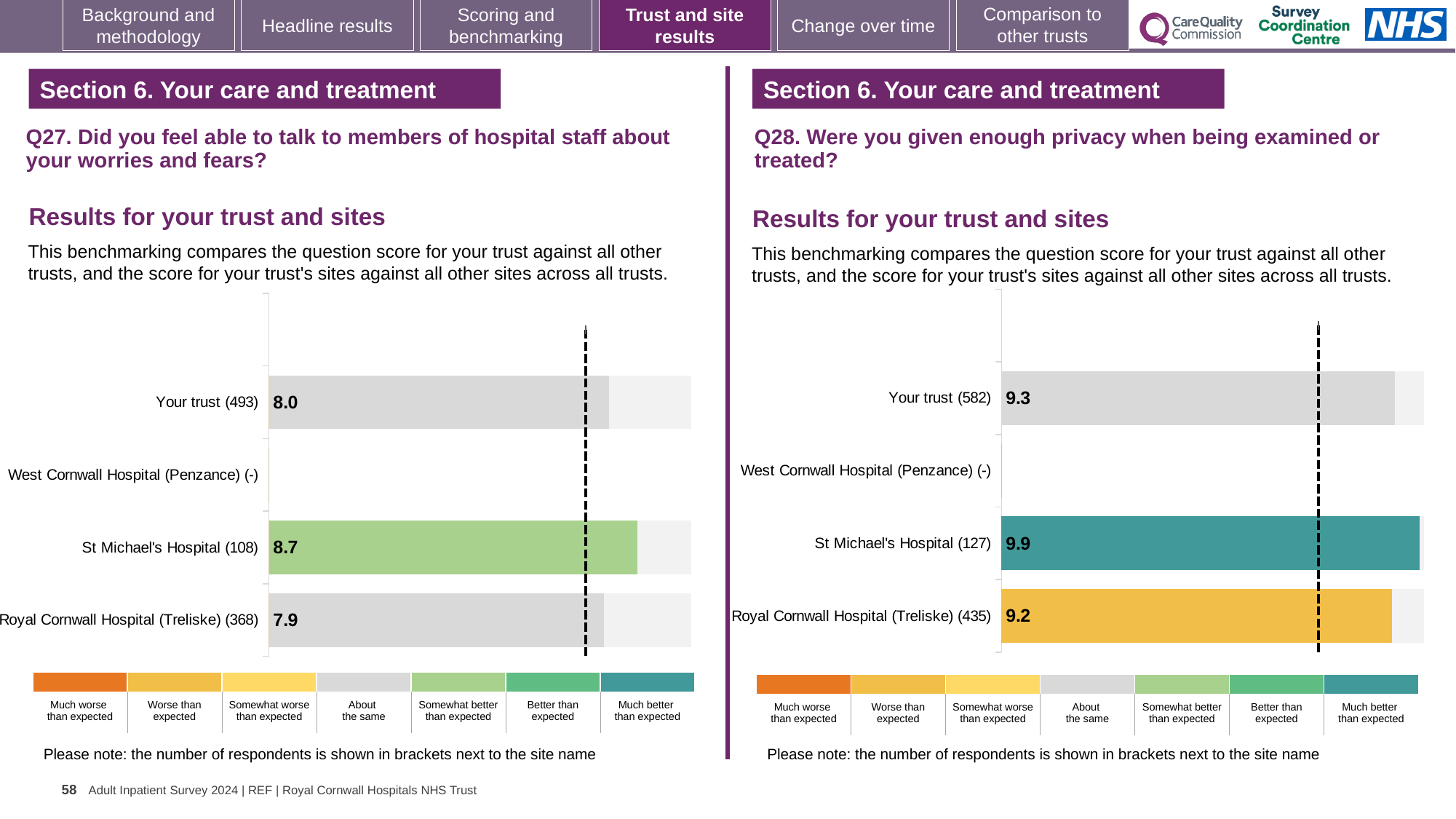
On the Q28 chart (right), what is the score for St Michael's Hospital? 9.9 On the Q27 chart (left), what is the score for Your trust? 8.0 On the Q28 chart (right), what is the difference between the scores for St Michael's Hospital and Your trust? 0.6 On the Q28 chart (right), which site has the lowest score among those with a score shown? Royal Cornwall Hospital (Treliske) On the Q28 chart (right), what is the score for Your trust? 9.3 What kind of chart is used on the Q27 chart (left)? Bar chart On the Q28 chart (right), which is larger: the score for Your trust or the score for Royal Cornwall Hospital (Treliske)? Your trust On the Q27 chart (left), what is the score for St Michael's Hospital? 8.7 On the Q27 chart (left), which site has the highest score? St Michael's Hospital On the Q27 chart (left), what is the difference between the scores for St Michael's Hospital and Royal Cornwall Hospital (Treliske)? 0.8 On the Q27 chart (left), what is the score for Royal Cornwall Hospital (Treliske)? 7.9 On the Q28 chart (right), what is the score for Royal Cornwall Hospital (Treliske)? 9.2